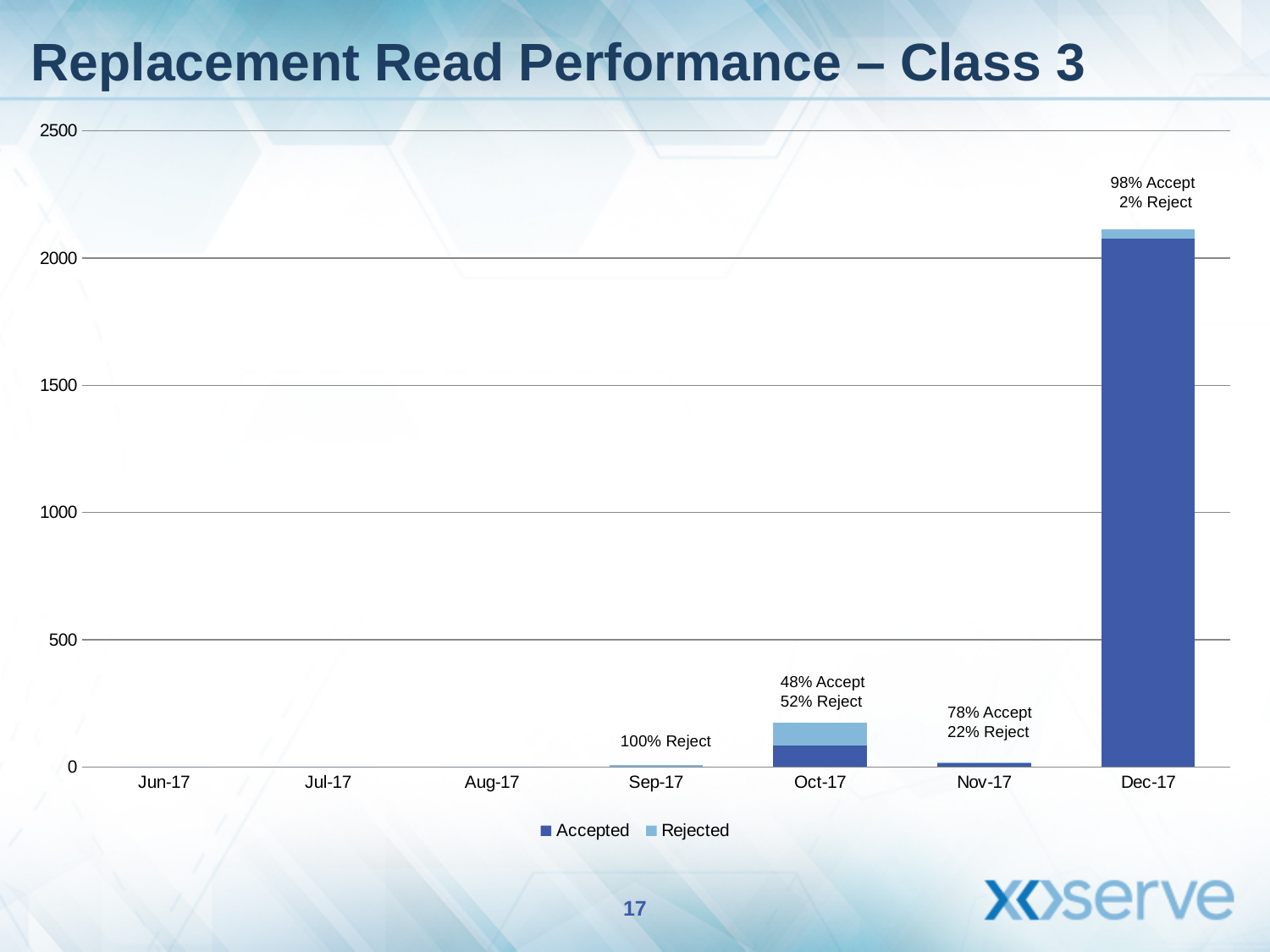
How many months are shown on the x axis? 7 What is the title of the chart? Replacement Read Performance – Class 3 What label is shown above the Sep-17 bar? 100% Reject What percentage of replacement reads were accepted in Nov-17? 78% Accept Is the total value for Oct-17 greater or less than 500? less Is the total value for Dec-17 greater or less than 2000? greater How many series does the legend list? 2 What percentage of replacement reads were rejected in Oct-17? 52% Reject What kind of chart is shown on the slide? Stacked bar chart Which month has the tallest bar? Dec-17 Which bar is taller, Oct-17 or Nov-17? Oct-17 What percentage of replacement reads were accepted in Dec-17? 98% Accept